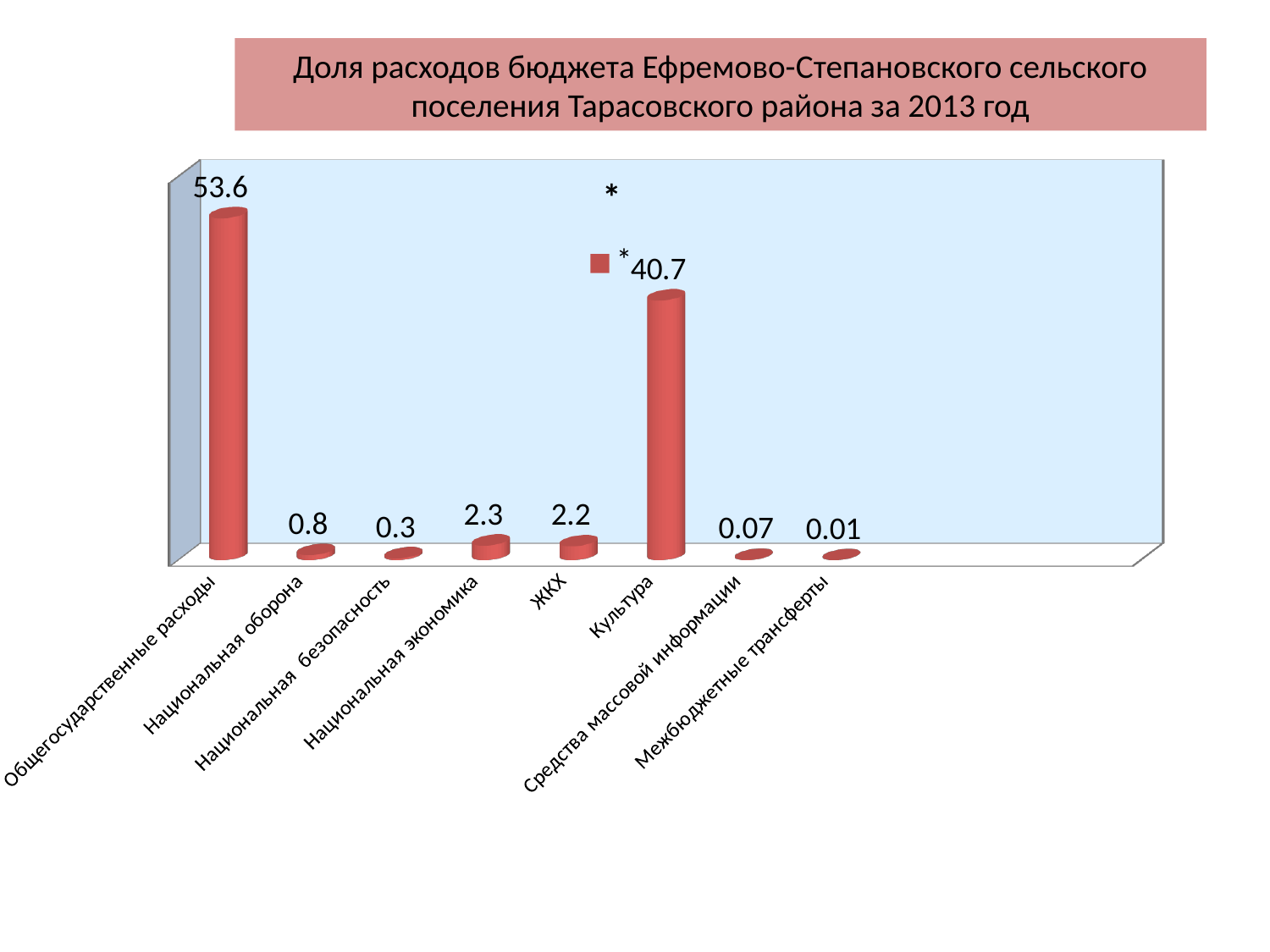
Which category has the lowest value? Межбюджетные трансферты How many categories are shown on the chart? 8 What is the title of the chart? Доля расходов бюджета Ефремово-Степановского сельского поселения Тарасовского района за 2013 год Which is larger, the value for Национальная оборона or the value for Национальная безопасность? Национальная оборона What is the value for Общегосударственные расходы? 53.6 What is the difference between the values for Общегосударственные расходы and Культура? 12.9 Which category has the highest value? Общегосударственные расходы What is the value for Культура? 40.7 What is the difference between the values for Национальная экономика and ЖКХ? 0.1 What is the value for Средства массовой информации? 0.07 What is the value for Национальная экономика? 2.3 What kind of chart is shown on the slide? bar chart